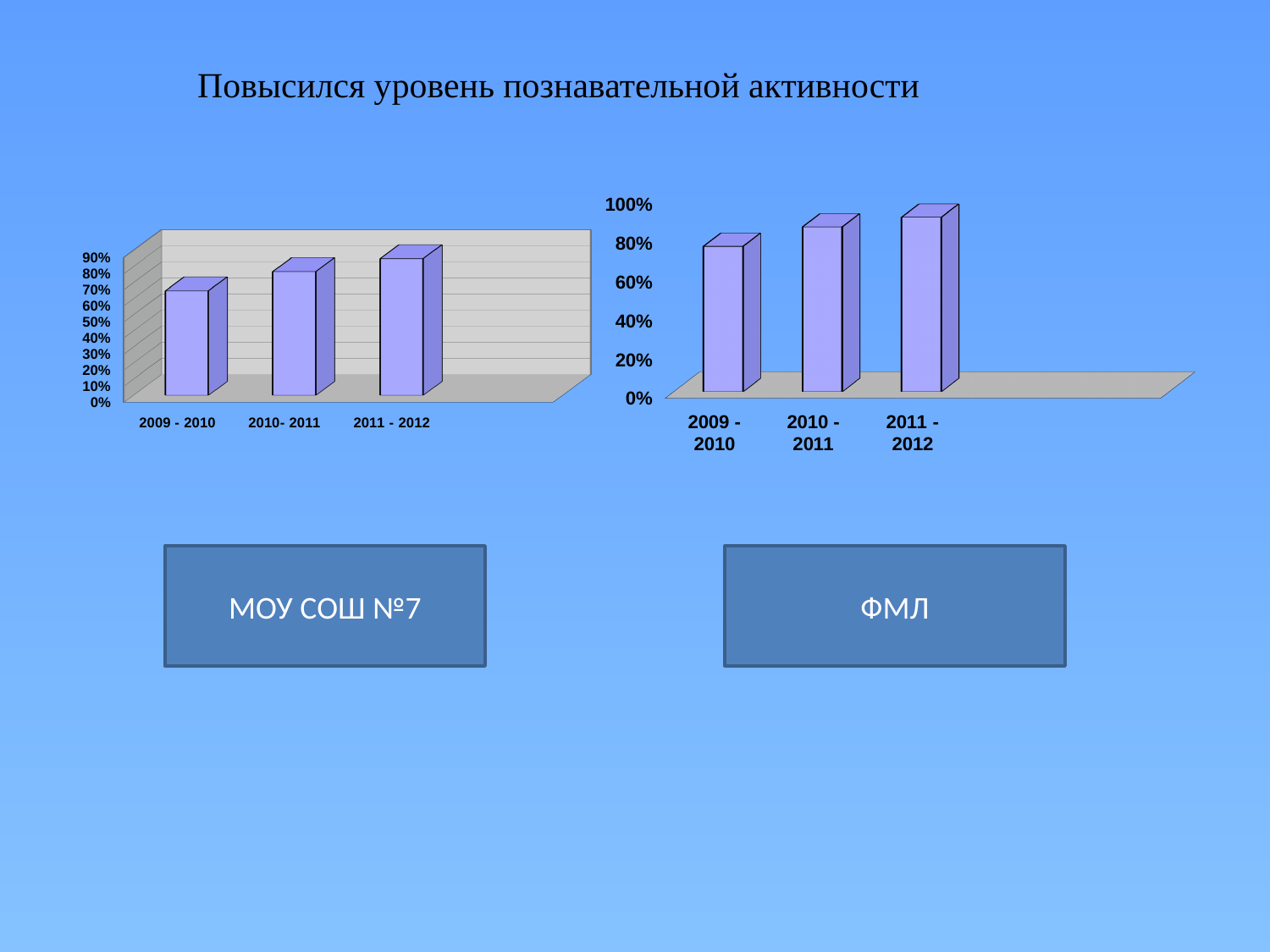
In the right chart (ФМЛ), which period has the highest value? 2011 - 2012 Do the values in the right chart (ФМЛ) rise or fall across the periods? rise Do the values in the left chart (МОУ СОШ №7) rise or fall from 2009 - 2010 to 2011 - 2012? rise In the right chart (ФМЛ), which is larger, the value for 2009 - 2010 or the value for 2011 - 2012? 2011 - 2012 In the left chart (МОУ СОШ №7), which period has the highest value? 2011 - 2012 In the left chart (МОУ СОШ №7), which period has the lowest value? 2009 - 2010 What is the label shown under the right chart? ФМЛ In the right chart (ФМЛ), is the value for 2009 - 2010 greater or less than 60%? greater What kind of chart is the left chart (МОУ СОШ №7)? bar chart How many categories are shown on the x axis of the right chart (ФМЛ)? 3 In the left chart (МОУ СОШ №7), is the value for 2009 - 2010 greater or less than 50%? greater In the right chart (ФМЛ), which period has the lowest value? 2009 - 2010